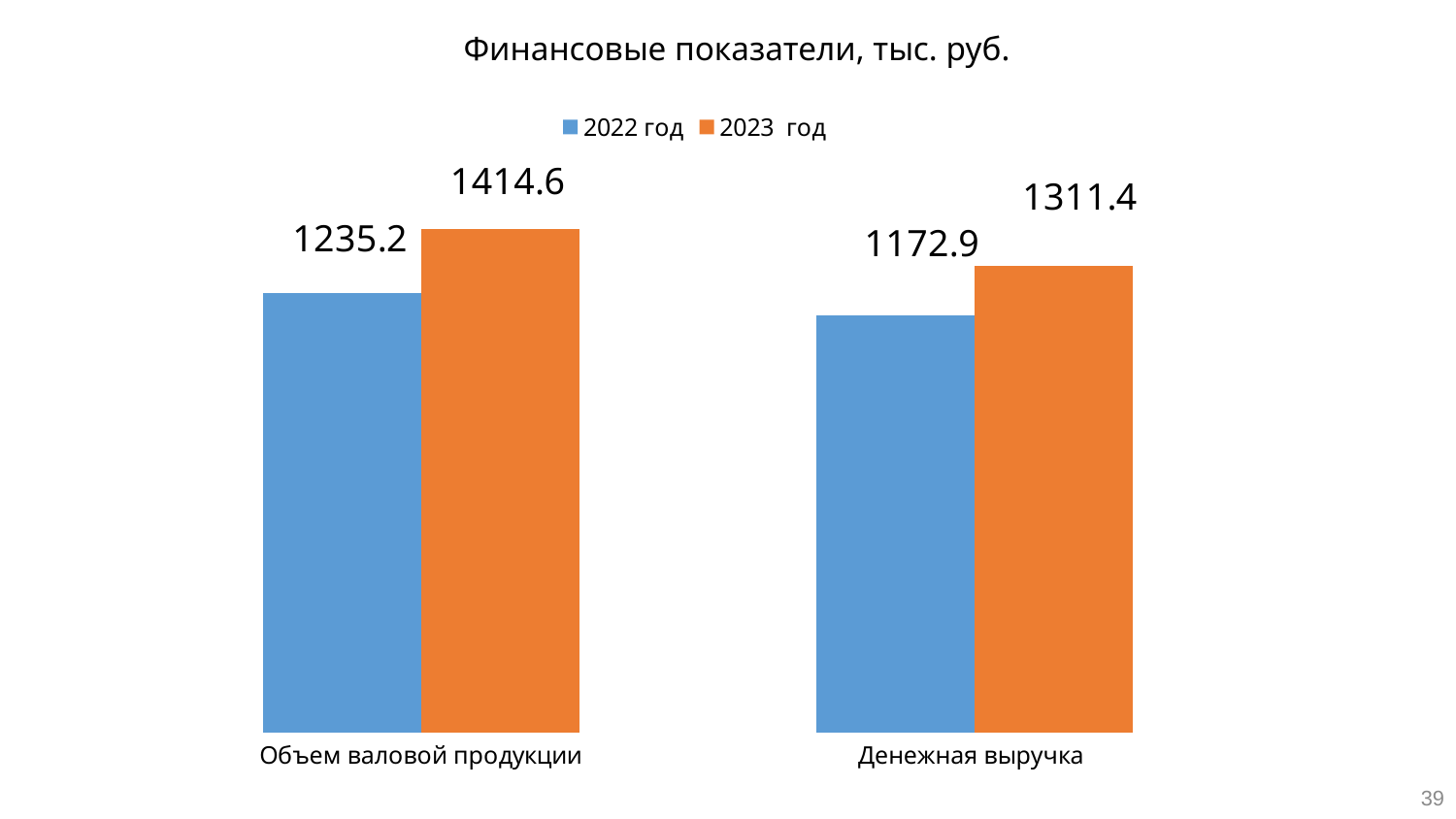
How many categories are shown on the x axis? 2 What is the value for Денежная выручка in 2022 год? 1172.9 Which is larger for Денежная выручка: the 2022 год value or the 2023 год value? 2023 год What is the difference between the 2023 год and 2022 год values for Объем валовой продукции? 179.4 Which category has the lowest value in the 2022 год series? Денежная выручка What is the value for Объем валовой продукции in 2023 год? 1414.6 How many series does the legend list? 2 What is the difference between the 2023 год and 2022 год values for Денежная выручка? 138.5 What kind of chart is shown on the slide? Bar chart What is the value for Денежная выручка in 2023 год? 1311.4 What is the value for Объем валовой продукции in 2022 год? 1235.2 Which category has the highest value in the 2023 год series? Объем валовой продукции